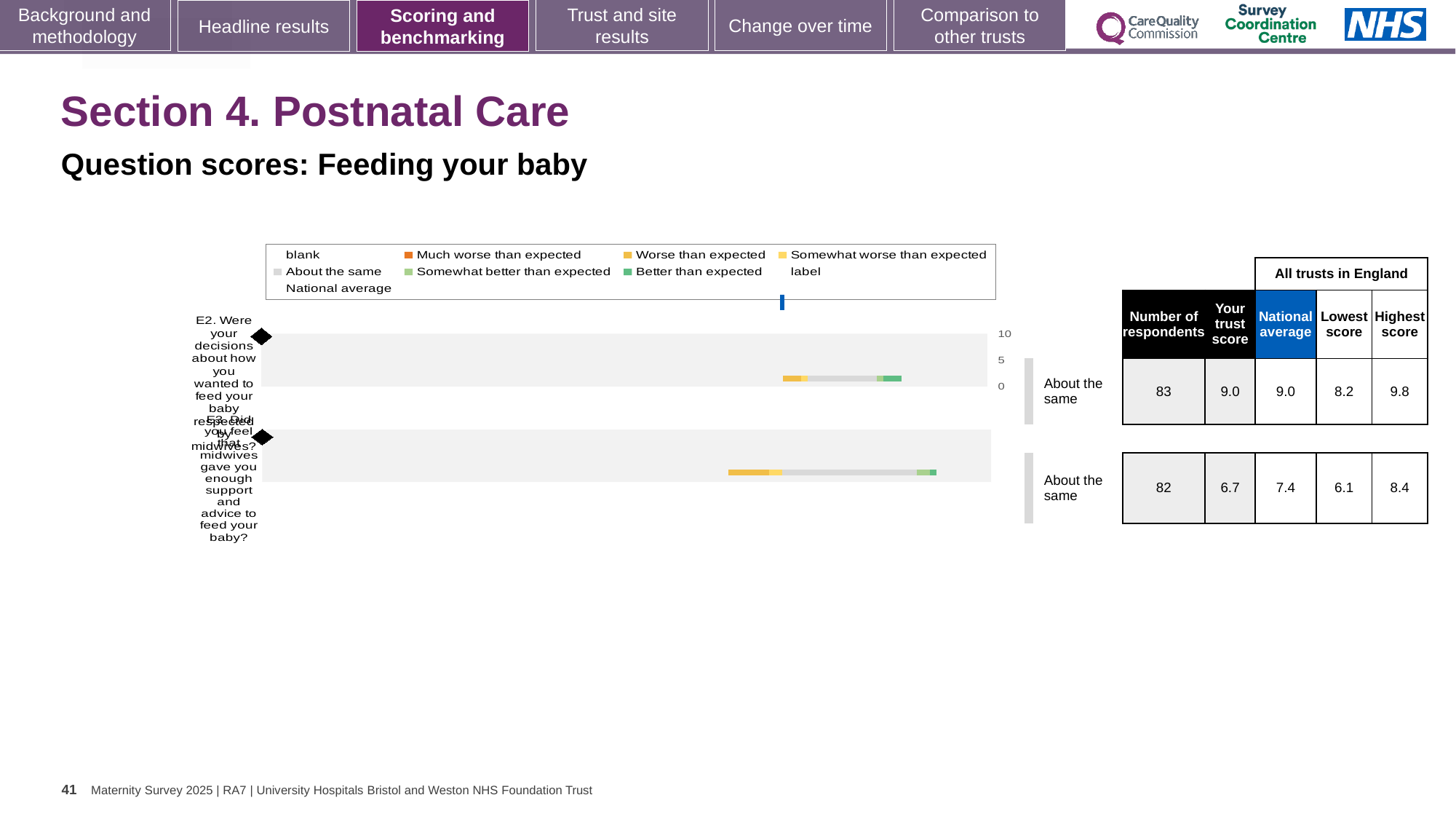
Which question has the higher trust score, E2 or E3? E2 What kind of chart is shown on the slide? Bar chart How many respondents answered question E3? 82 What colour does the legend use for 'Better than expected'? Green How many survey questions are plotted in the chart? 2 By how much is the national average higher than the trust score for question E3? 0.7 What is the highest score across all trusts in England for question E3? 8.4 What benchmark category is shown next to the bar for question E2? About the same What is the national average for question E3 (midwives gave you enough support and advice to feed your baby)? 7.4 What is the trust score for question E2 (decisions about how you wanted to feed your baby respected by midwives)? 9.0 Which question has the higher 'Highest score' value, E2 or E3? E2 What is the difference between the highest score and the lowest score for question E2? 1.6